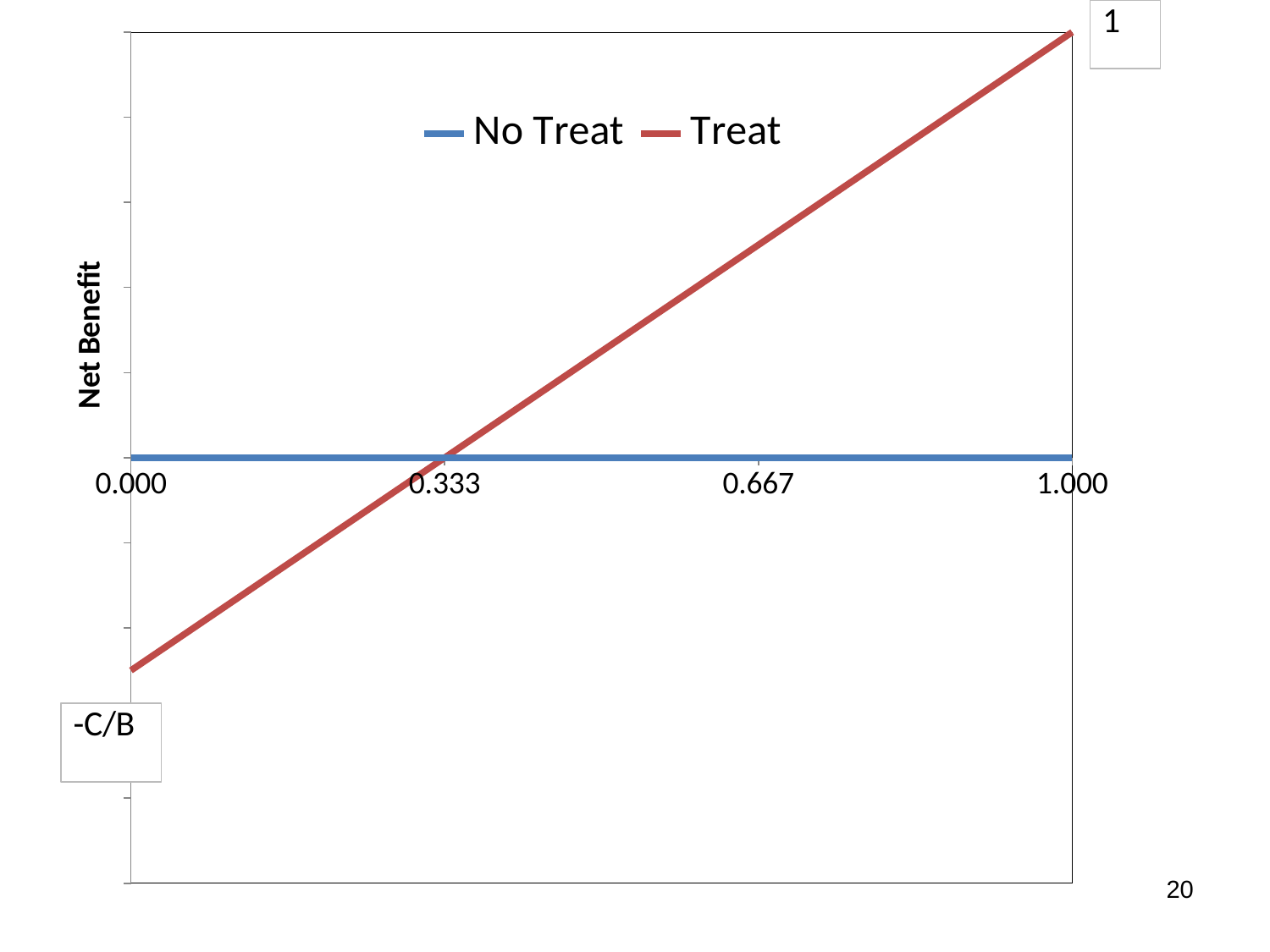
Does the No Treat line rise, fall, or stay flat across the x axis? stay flat What kind of chart is shown on the slide? line chart At x = 0.000, which series has the higher Net Benefit, Treat or No Treat? No Treat At which x-axis tick value does the Treat line cross the No Treat line? 0.333 At x = 1.000, which series has the higher Net Benefit, Treat or No Treat? Treat What are the two series named in the legend? No Treat and Treat How many series does the legend list? 2 How many tick labels are shown on the x axis? 4 What value is labelled at the right end of the Treat line, at x = 1.000? 1 What is the label on the vertical axis? Net Benefit Does the Treat line rise or fall as the x-axis value increases from 0.000 to 1.000? rise What value is labelled at the left end of the Treat line, at x = 0.000? -C/B